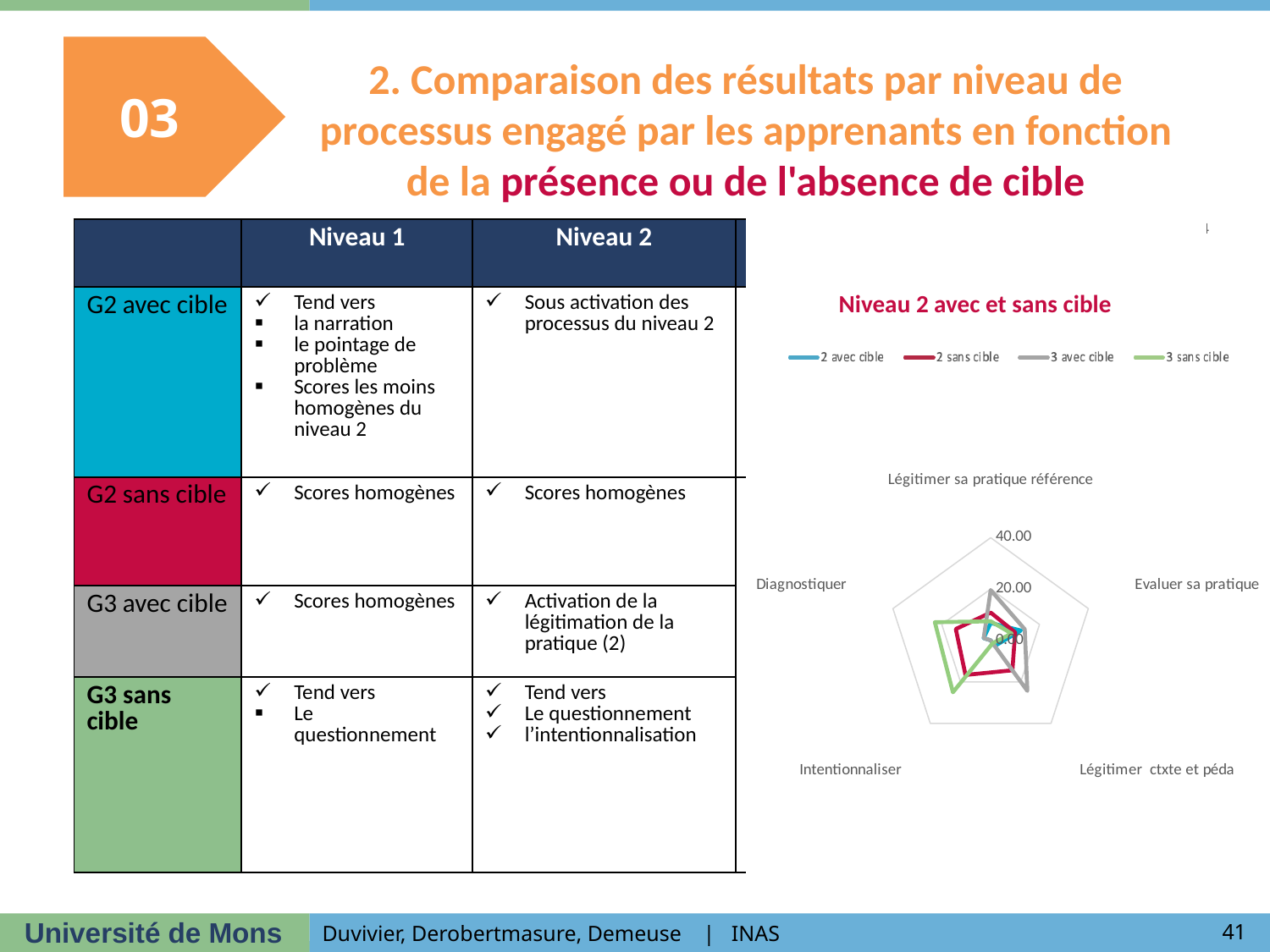
How many series does the chart's legend list? 4 What is the highest value shown on the chart's axis scale? 40.00 Is the value for 3 avec cible on Intentionnaliser greater or less than 40.00? less Is the value for 2 avec cible on Légitimer ctxte et péda greater or less than 20.00? less Is the value for 2 sans cible on Evaluer sa pratique greater or less than 40.00? less How many axes (categories) does the radar chart have? 5 What kind of chart is shown on the slide? Radar chart Which series are listed in the chart's legend? 2 avec cible, 2 sans cible, 3 avec cible, 3 sans cible What is the title of the chart on the slide? Niveau 2 avec et sans cible